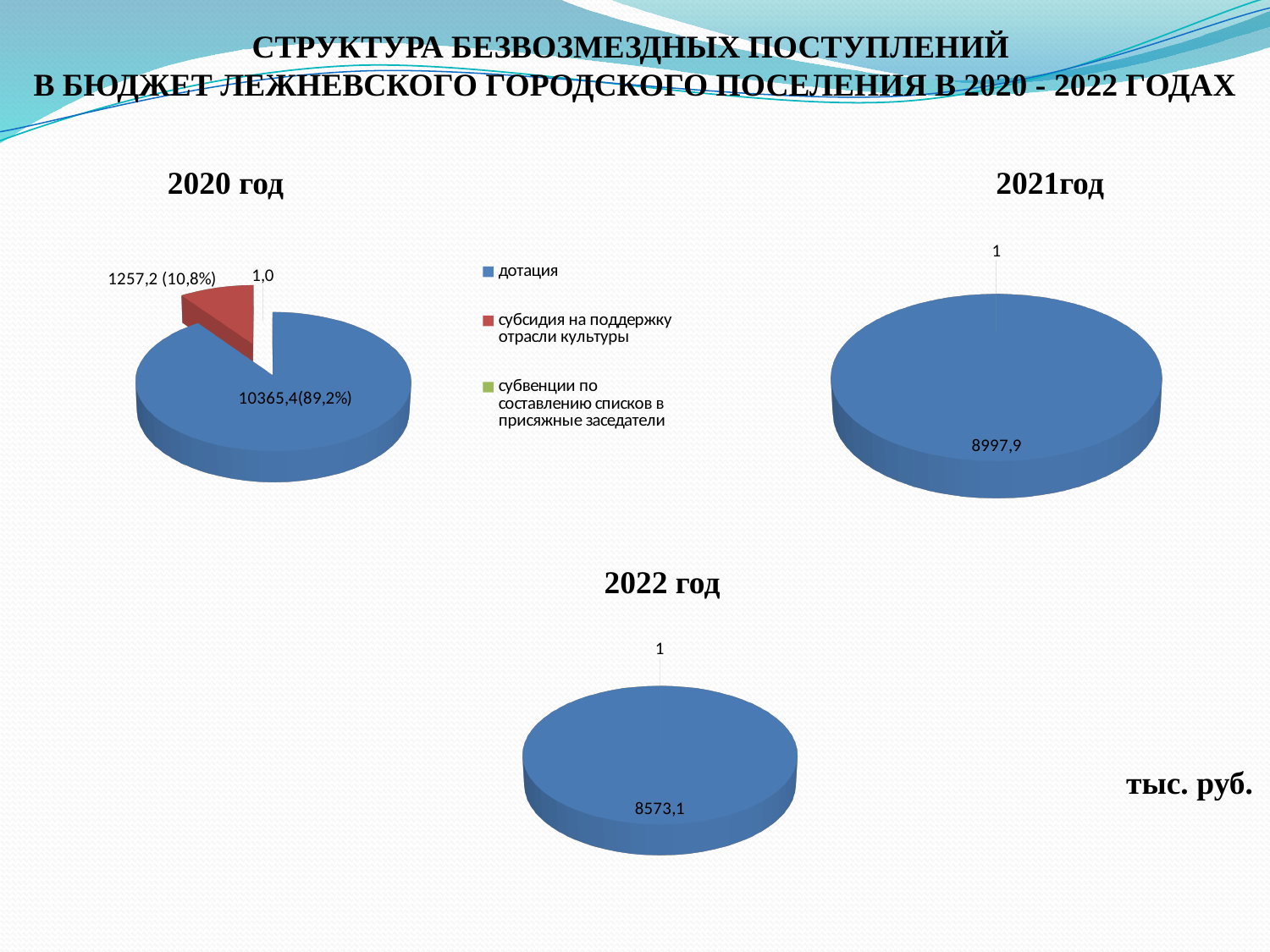
Is the дотация value larger in the 2021год chart or in the 2022 год chart? 2021год In the 2021год pie chart, what value is shown for дотация? 8997,9 In the 2020 год pie chart, what value is shown for дотация? 10365,4 In the 2020 год pie chart, what value is shown for субсидия на поддержку отрасли культуры? 1257,2 How many entries does the legend on the slide list? 3 What is the difference between the дотация value in the 2021год chart and the дотация value in the 2022 год chart? 424,8 In the 2020 год pie chart, what share of the pie does субсидия на поддержку отрасли культуры take? 10,8% What type of chart is used for the 2020 год, 2021год and 2022 год data? Pie chart In the 2022 год pie chart, what value is shown for дотация? 8573,1 In the 2020 год pie chart, which category has the largest slice? дотация In the 2020 год pie chart, what share of the pie does дотация take? 89,2% In the 2020 год pie chart, what is the difference between the дотация value and the субсидия на поддержку отрасли культуры value? 9108,2